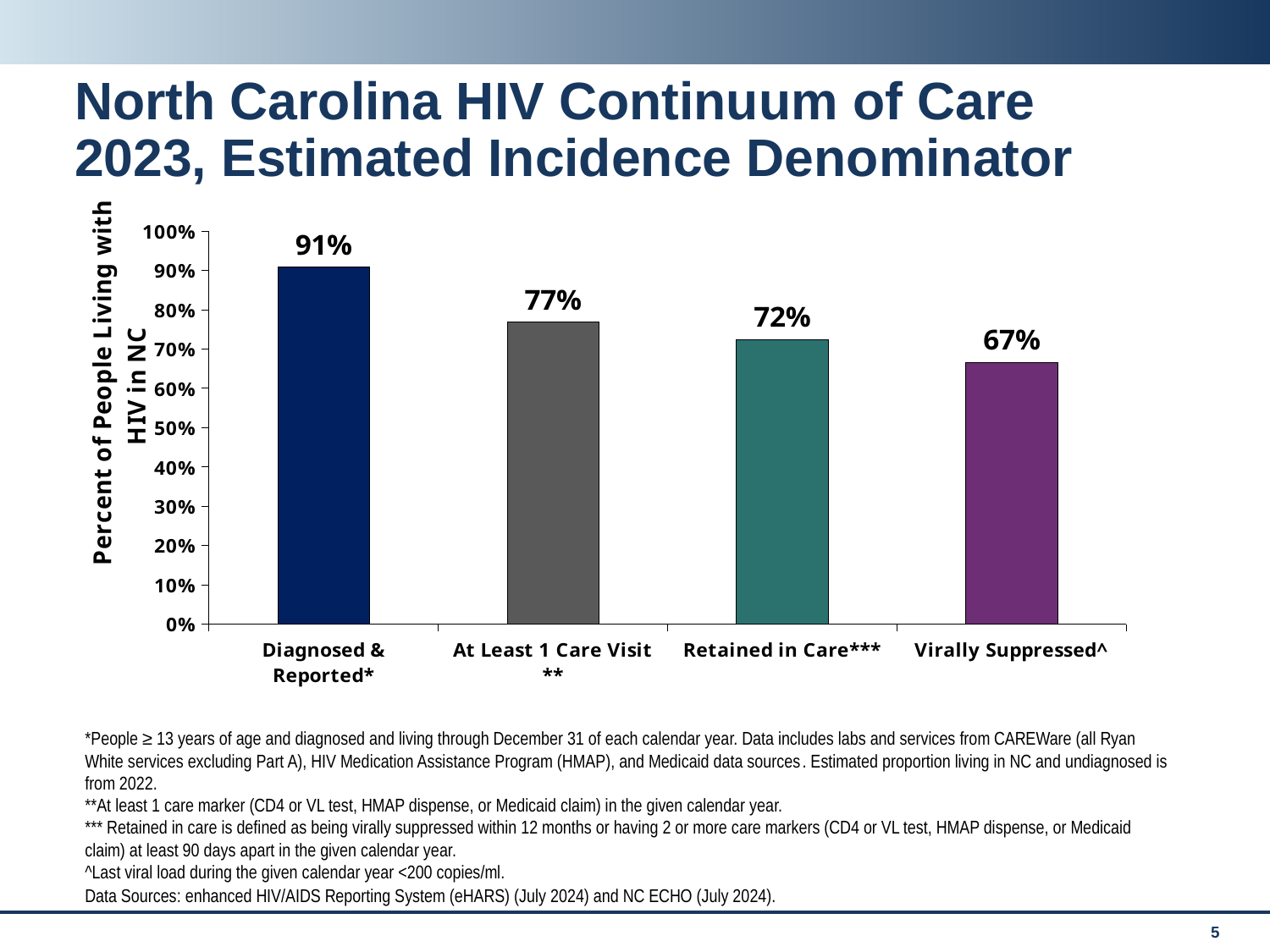
What is the difference between At Least 1 Care Visit and Retained in Care? 5 percentage points Which category has the highest value? Diagnosed & Reported What is the difference between Diagnosed & Reported and Virally Suppressed? 24 percentage points What kind of chart is shown on the slide? Bar chart What is the value for At Least 1 Care Visit? 77% Which is larger, Retained in Care or Virally Suppressed? Retained in Care What percentage of people living with HIV in NC are Diagnosed & Reported? 91% What is the value for Retained in Care? 72% How many categories are shown on the x axis? 4 Do the values rise or fall from left to right along the x axis? Fall Which category has the lowest value? Virally Suppressed What is the value for Virally Suppressed? 67%